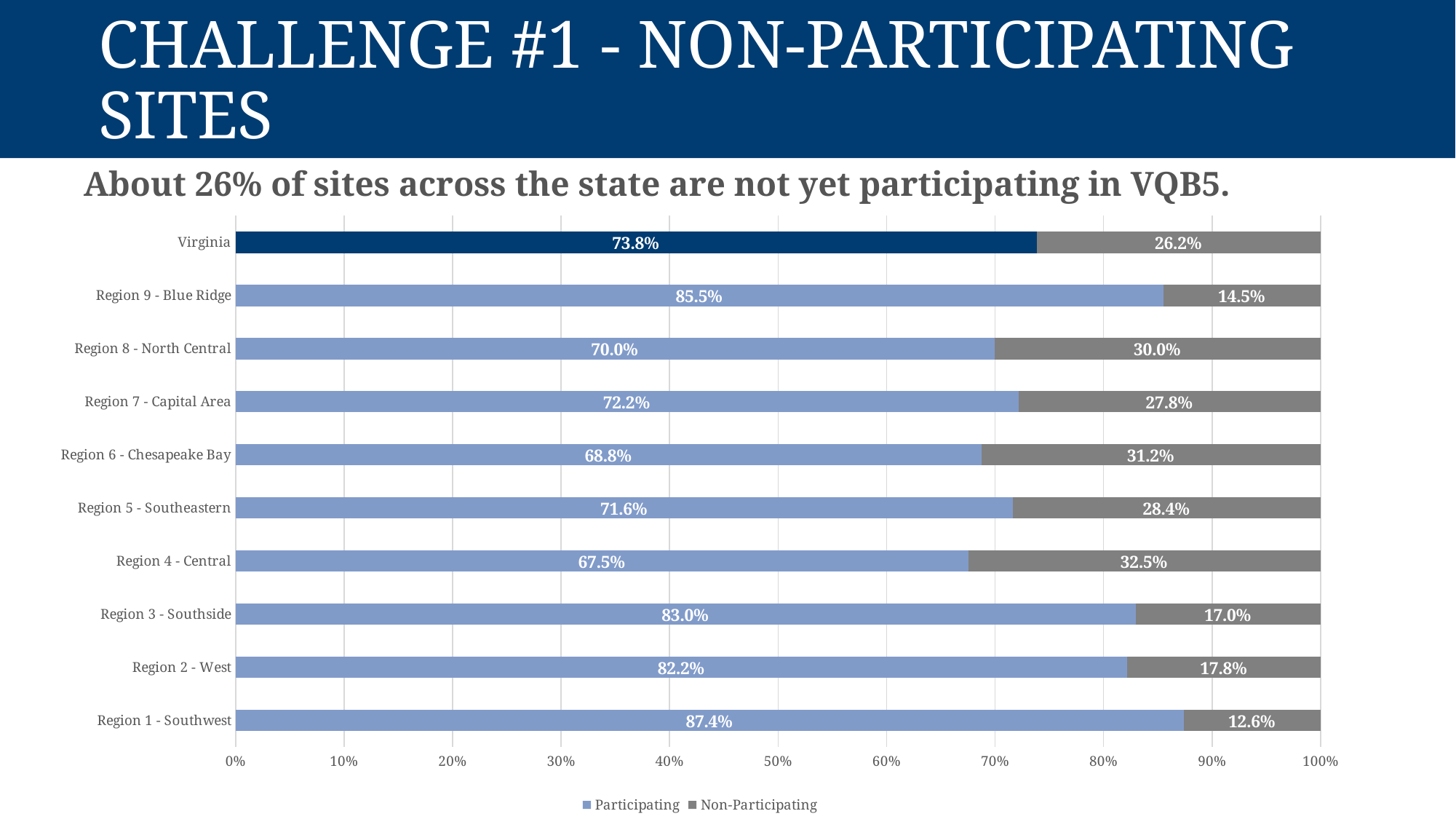
Which has a larger Non-Participating value, Region 8 - North Central or Region 7 - Capital Area? Region 8 - North Central Which region has the lowest Participating value? Region 4 - Central How many series does the legend list? 2 How many categories are shown on the y axis? 10 What is the total of the stacked bar for Region 3 - Southside? 100.0% What is the Participating value for Region 9 - Blue Ridge? 85.5% What is the Participating value for Virginia? 73.8% What is the Non-Participating value for Region 4 - Central? 32.5% Which region has the highest Participating value? Region 1 - Southwest Which region has the highest Non-Participating value? Region 4 - Central What kind of chart is shown on the slide? Stacked bar chart What is the difference between the Participating values for Region 1 - Southwest and Region 2 - West? 5.2%